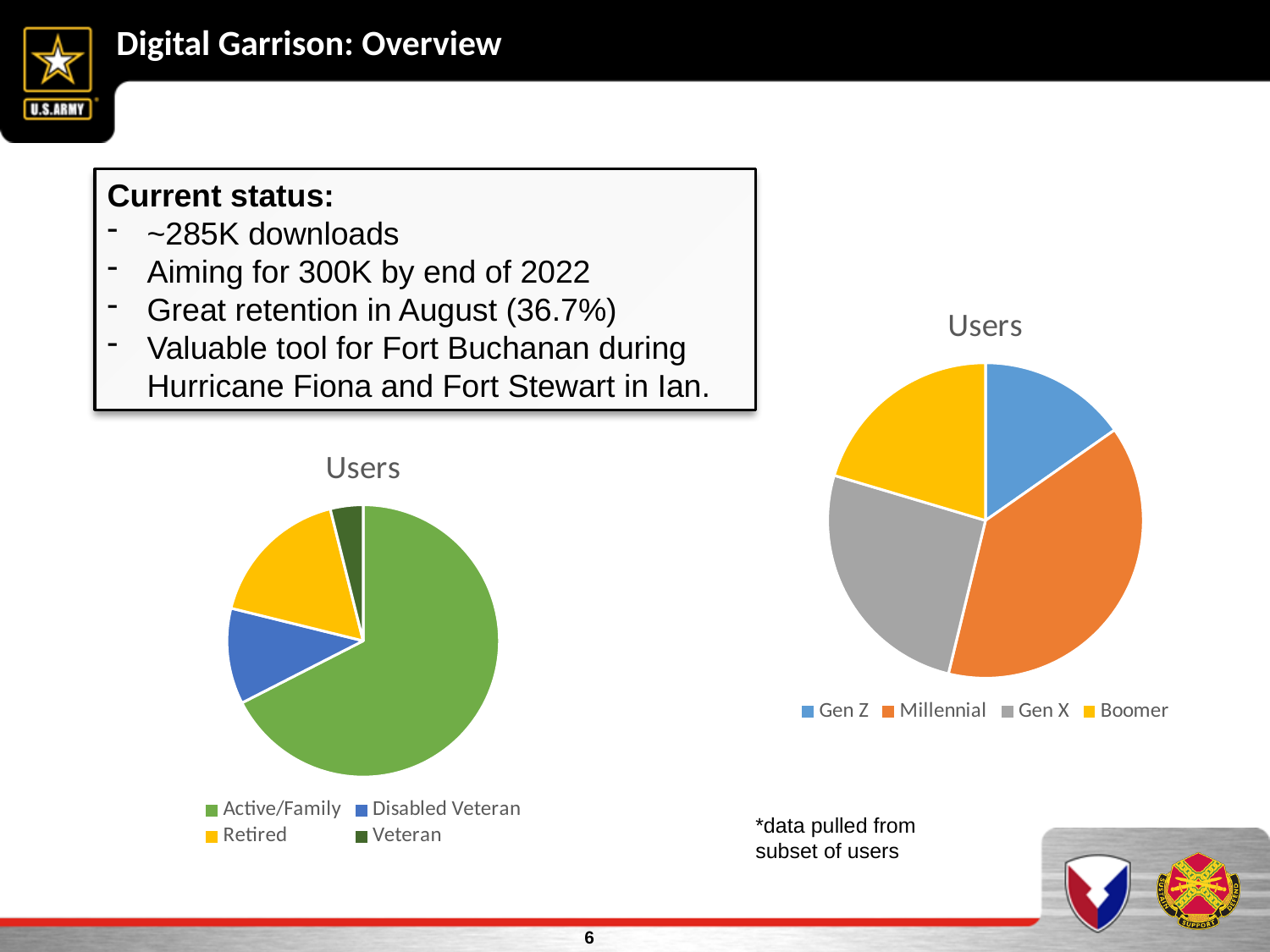
In the left pie chart, which category has the largest slice? Active/Family In the right pie chart, what colour is the Gen X slice? Grey What kind of chart is the right chart titled "Users"? Pie chart In the right pie chart, how many categories does the legend list? 4 In the left pie chart, how many categories does the legend list? 4 In the left pie chart, what colour is the Active/Family slice? Green In the left pie chart, which category has the smallest slice? Veteran What kind of chart is the left chart titled "Users"? Pie chart In the right pie chart, which slice is larger, Millennial or Gen X? Millennial In the right pie chart, which slice is larger, Gen Z or Millennial? Millennial In the right pie chart, which category has the largest slice? Millennial In the left pie chart, which slice is larger, Retired or Disabled Veteran? Retired